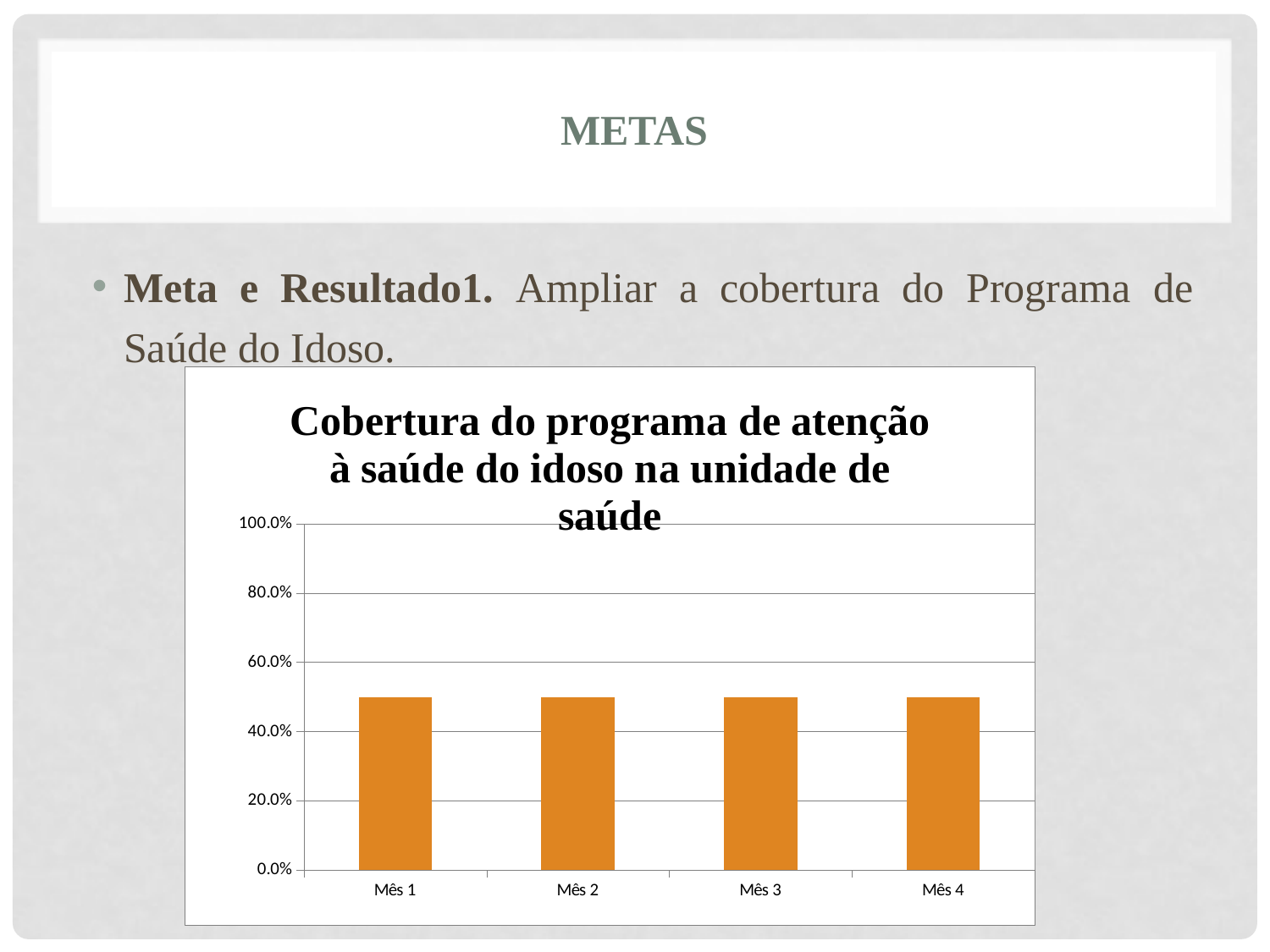
Do the values rise, fall, or stay roughly constant from Mês 1 to Mês 4? stay roughly constant What is the highest value shown on the y axis of the chart? 100.0% What is the label of the first category on the x axis? Mês 1 Is the value for Mês 1 greater or less than 40.0%? greater Is the value for Mês 3 greater or less than 80.0%? less What kind of chart is shown on the slide? bar chart Is the value for Mês 2 greater or less than 60.0%? less How many categories are plotted on the x axis of the chart? 4 What is the title of the chart? Cobertura do programa de atenção à saúde do idoso na unidade de saúde